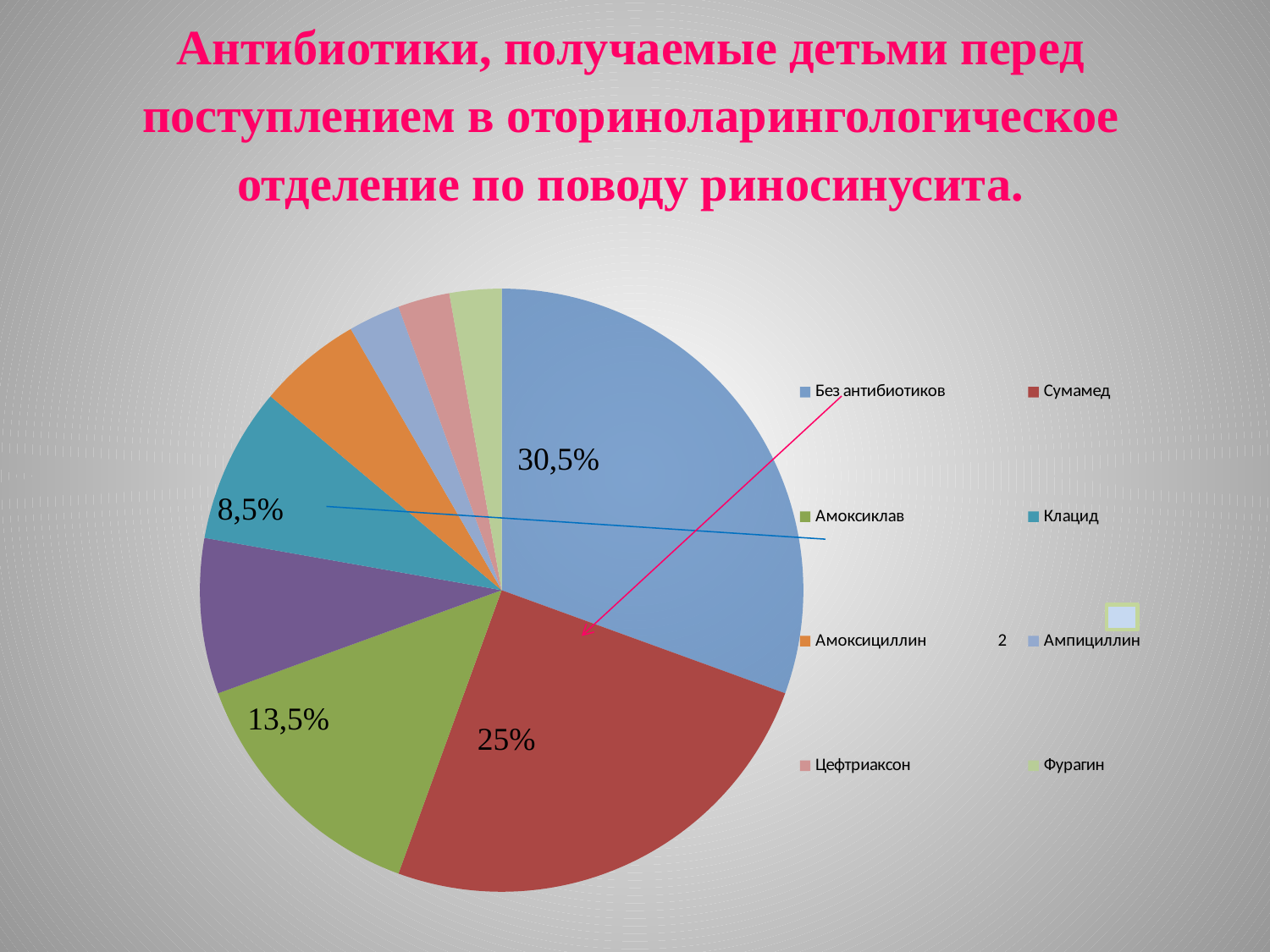
How many slices does the pie chart have? 9 What is the difference between the shares for Сумамед and Амоксиклав? 11,5% What kind of chart is shown on the slide? Pie chart Which category has the largest slice of the pie? Без антибиотиков What share of the pie is labelled for Амоксиклав? 13,5% Which slice is larger, Клацид or Амоксиклав? Амоксиклав What share of the pie is labelled for Без антибиотиков? 30,5% What share of the pie is labelled for Клацид? 8,5% Which slice is larger, Сумамед or Амоксиклав? Сумамед What is the difference between the shares for Без антибиотиков and Сумамед? 5,5% What colour is the slice for Сумамед in the legend? Red What share of the pie is labelled for Сумамед? 25%